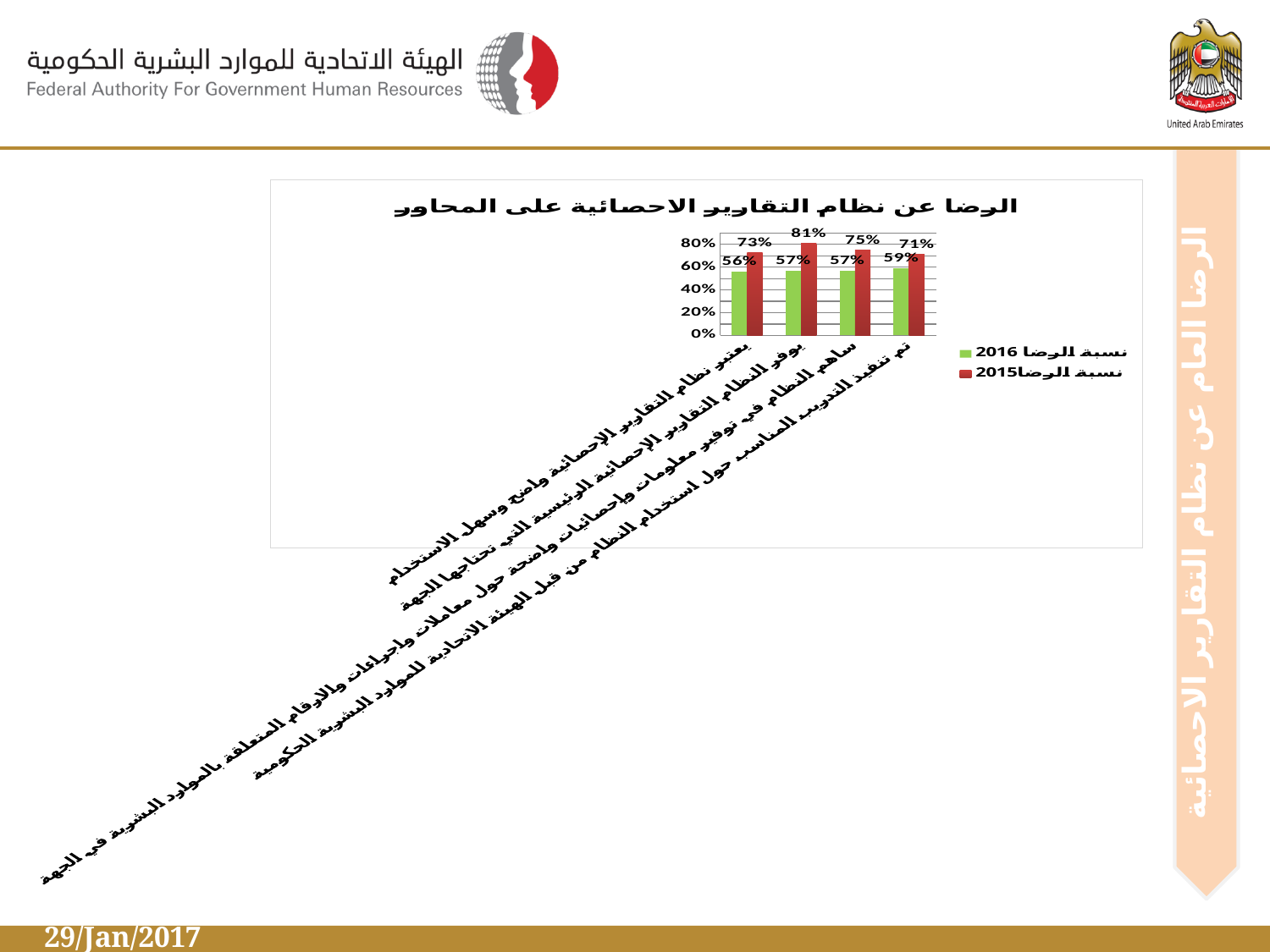
What is the 2016 satisfaction value (نسبة الرضا 2016) for the first category on the left? 56% What is the lowest value in the 2016 series (نسبة الرضا 2016)? 56% How many categories are plotted along the x axis of the chart? 4 What is the title of the chart? الرضا عن نظام التقارير الاحصائية على المحاور Which series is shown in green in the chart? نسبة الرضا 2016 What is the highest value in the 2015 series (نسبة الرضا 2015)? 81% What kind of chart is shown on the slide? bar chart How many series does the chart legend list? 2 What is the 2015 satisfaction value (نسبة الرضا 2015) for the fourth (rightmost) category? 71% Is the 2015 value for the third category greater or less than 60%? greater For the first category, which series has the larger value, 2015 or 2016? نسبة الرضا 2015 For the second category, what is the difference between the 2015 value and the 2016 value? 24 percentage points